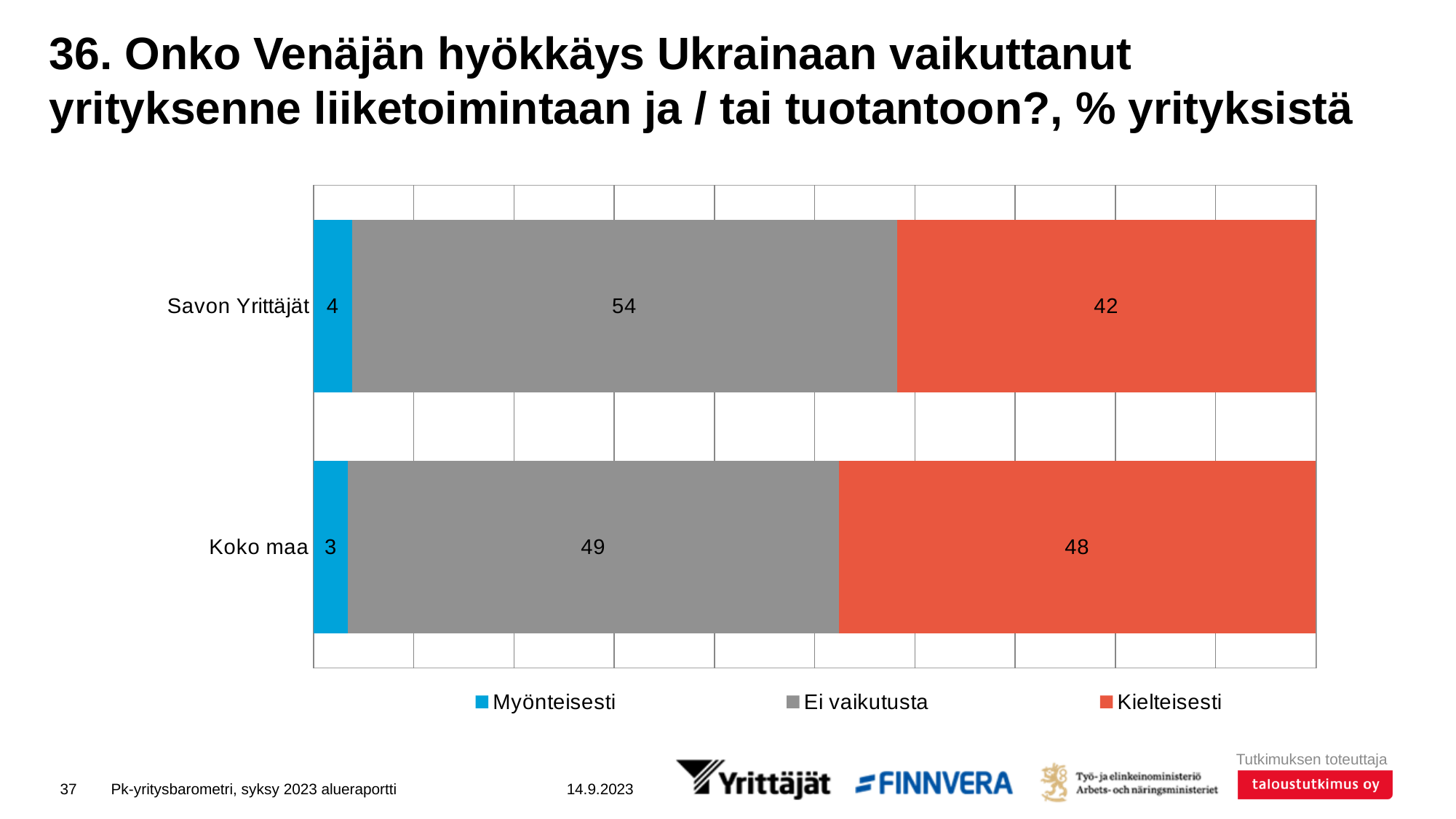
What is the total of the stacked bar for Savon Yrittäjät? 100 Which category has the lower value for Ei vaikutusta? Koko maa What is the value for Kielteisesti for Koko maa? 48 How many series does the legend list? 3 What is the value for Myönteisesti for Koko maa? 3 What is the value for Myönteisesti for Savon Yrittäjät? 4 Is the Kielteisesti value larger for Savon Yrittäjät or for Koko maa? Koko maa Which category has the higher value for Kielteisesti? Koko maa What is the difference between the Ei vaikutusta values for Savon Yrittäjät and Koko maa? 5 What kind of chart is shown? Stacked bar chart How many categories are shown on the y axis? 2 What is the value for Ei vaikutusta for Savon Yrittäjät? 54